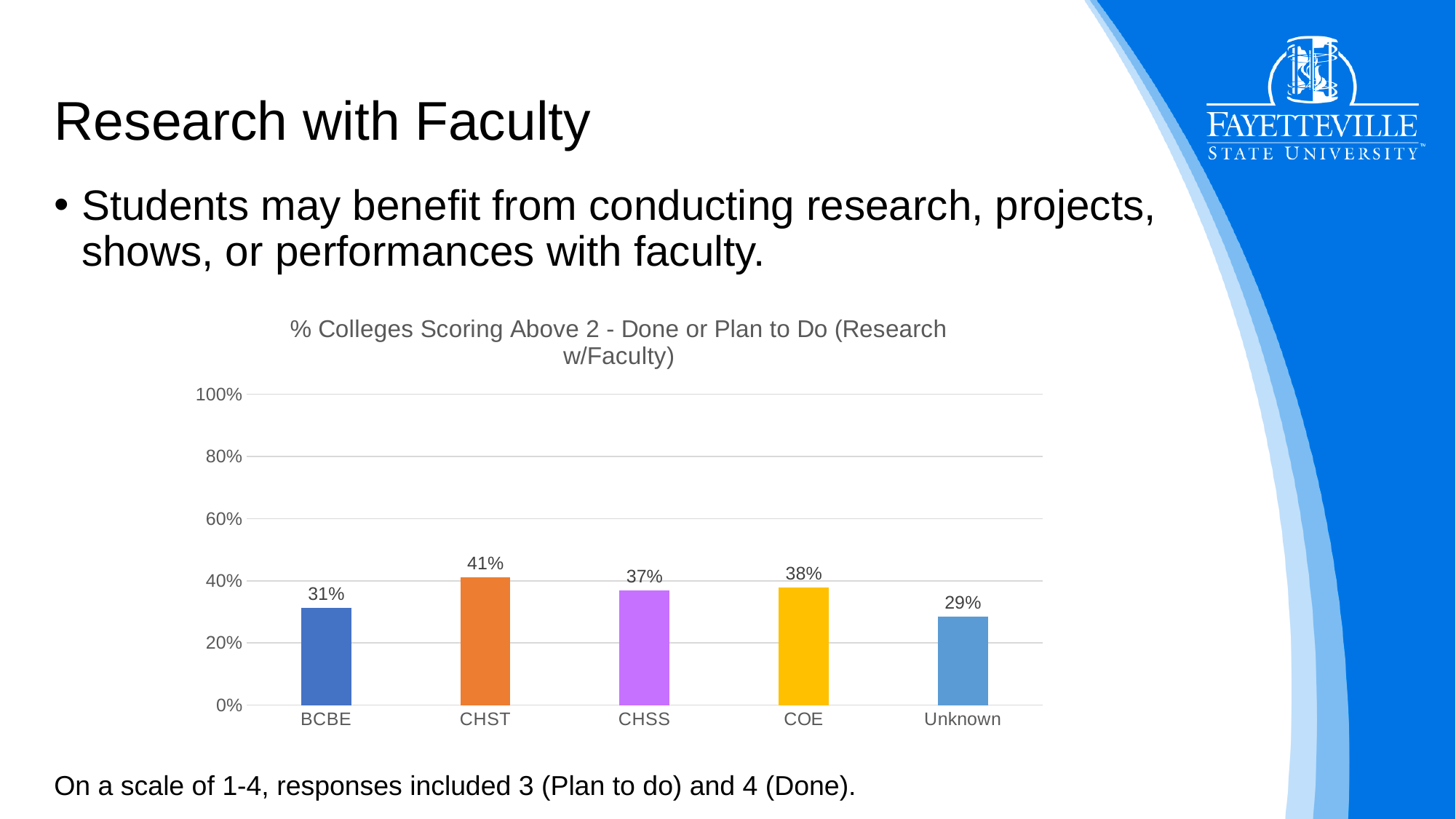
Is the value for COE greater or less than 60%? less Which is larger, the value for CHSS or the value for BCBE? CHSS What is the value for BCBE? 31% What is the difference between the values for CHST and BCBE? 10% What kind of chart is shown on the slide? bar chart What is the value for CHST? 41% What is the title of the chart? % Colleges Scoring Above 2 - Done or Plan to Do (Research w/Faculty) How many categories are shown on the x axis? 5 What is the difference between the values for COE and Unknown? 9% Which category has the lowest value? Unknown Which category has the highest value? CHST What is the value for Unknown? 29%